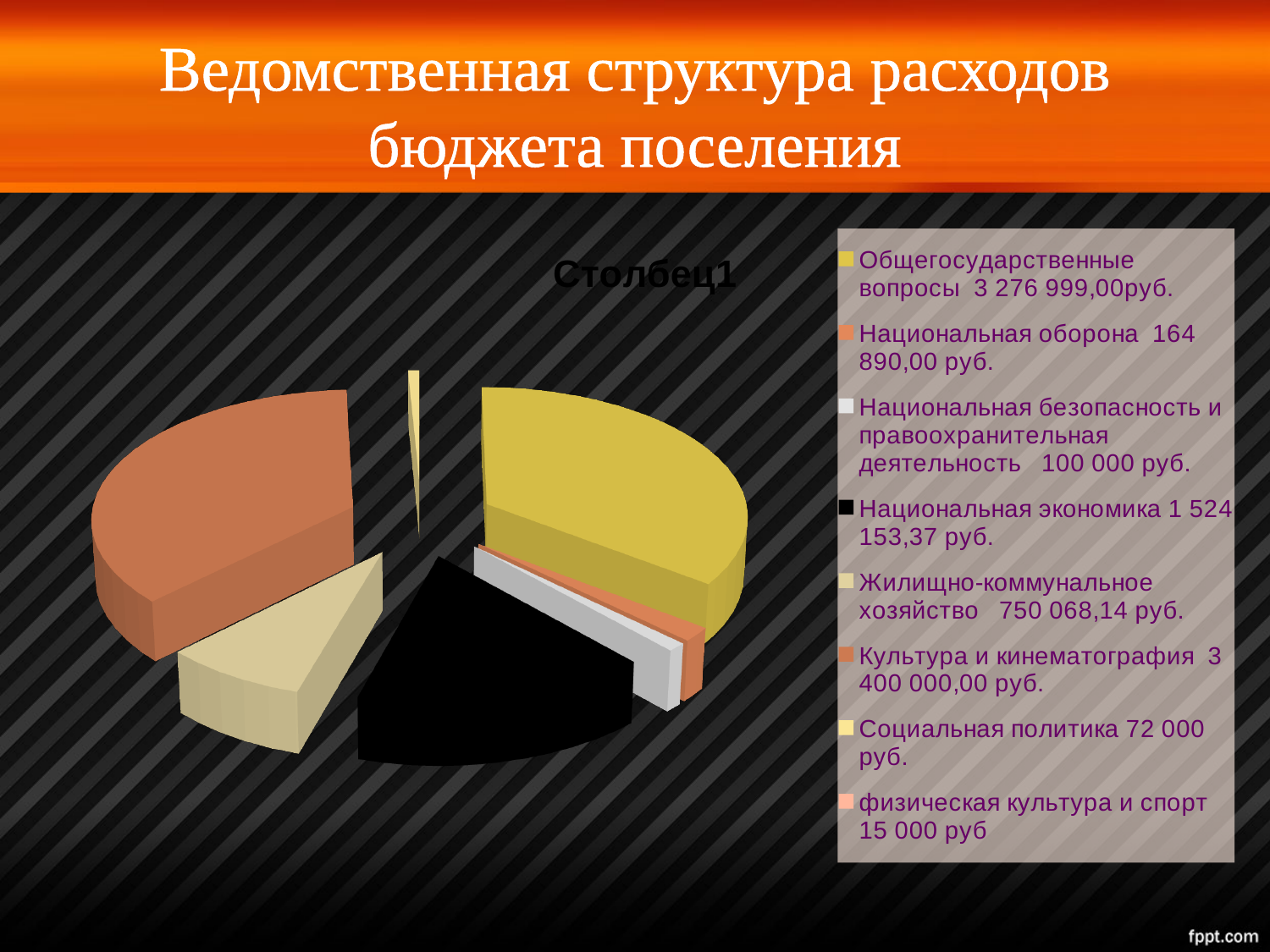
What is the value for Национальная оборона? 164 890,00 руб. What kind of chart is shown on the slide? Pie chart What is the value for Общегосударственные вопросы? 3 276 999,00руб. What is the title of the chart? Столбец1 What is the value for Национальная экономика? 1 524 153,37 руб. What is the value for Социальная политика? 72 000 руб. What is the value for Жилищно-коммунальное хозяйство? 750 068,14 руб. How many categories does the chart's legend list? 8 What is the difference between the values for Культура и кинематография and Общегосударственные вопросы? 123 001,00 руб. Which category has the highest value? Культура и кинематография Which category has the lowest value? физическая культура и спорт Which is larger, the value for Национальная экономика or the value for Жилищно-коммунальное хозяйство? Национальная экономика